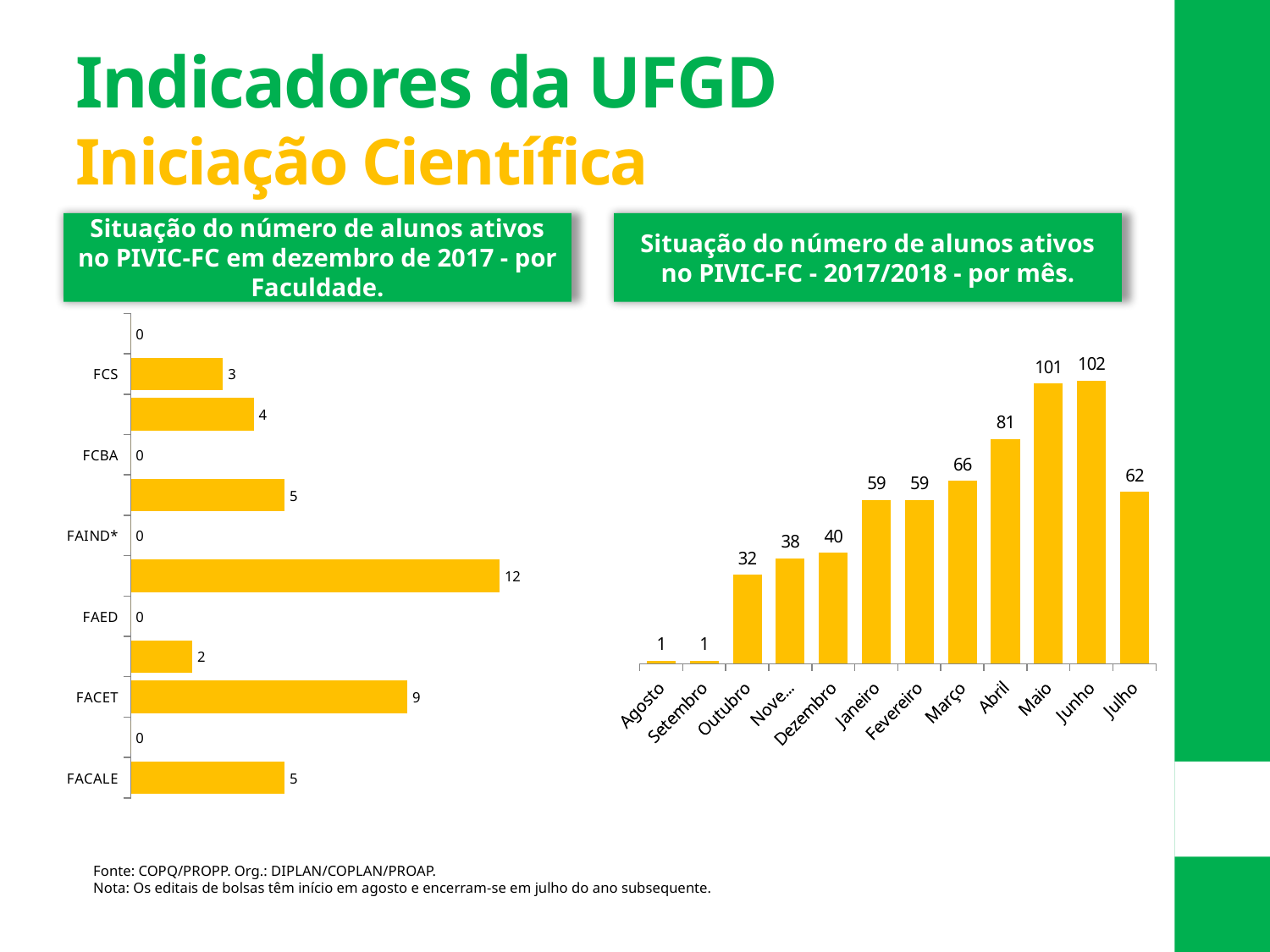
In the chart 'Situação do número de alunos ativos no PIVIC-FC em dezembro de 2017 - por Faculdade', what is the value for FCS? 3 In the chart 'Situação do número de alunos ativos no PIVIC-FC - 2017/2018 - por mês', which is larger, the value for Abril or the value for Março? Abril In the chart 'Situação do número de alunos ativos no PIVIC-FC - 2017/2018 - por mês', how many months are plotted? 12 In the chart 'Situação do número de alunos ativos no PIVIC-FC - 2017/2018 - por mês', what is the difference between the values for Junho and Julho? 40 In the chart 'Situação do número de alunos ativos no PIVIC-FC em dezembro de 2017 - por Faculdade', what is the value for FACET? 9 In the chart 'Situação do número de alunos ativos no PIVIC-FC em dezembro de 2017 - por Faculdade', what is the difference between the values for FACET and FACALE? 4 In the chart 'Situação do número de alunos ativos no PIVIC-FC - 2017/2018 - por mês', which month has the highest value? Junho In the chart 'Situação do número de alunos ativos no PIVIC-FC - 2017/2018 - por mês', what is the value for Outubro? 32 In the chart 'Situação do número de alunos ativos no PIVIC-FC - 2017/2018 - por mês', do the values rise or fall from Agosto to Junho? rise What kind of chart is 'Situação do número de alunos ativos no PIVIC-FC em dezembro de 2017 - por Faculdade'? bar chart In the chart 'Situação do número de alunos ativos no PIVIC-FC em dezembro de 2017 - por Faculdade', what is the largest value shown on any bar? 12 In the chart 'Situação do número de alunos ativos no PIVIC-FC - 2017/2018 - por mês', what is the value for Maio? 101